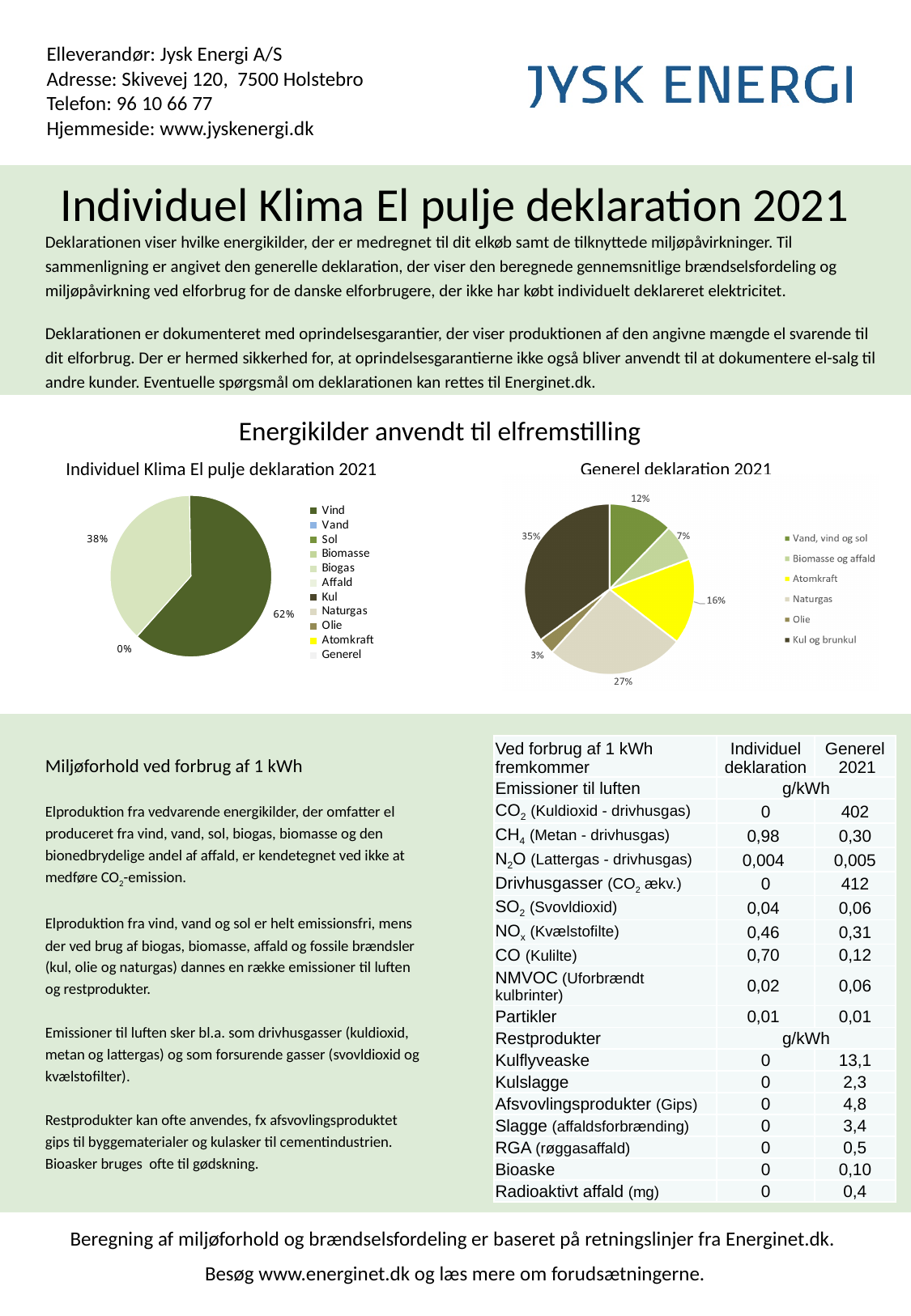
In the 'Generel deklaration 2021' chart, which is larger: Vand, vind og sol or Biomasse og affald? Vand, vind og sol In the 'Generel deklaration 2021' chart, which category has the largest slice? Kul og brunkul How many entries does the legend of the 'Individuel Klima El pulje deklaration 2021' chart list? 11 In the 'Generel deklaration 2021' chart, which category has the smallest slice? Olie In the 'Individuel Klima El pulje deklaration 2021' chart, what is the share of the largest slice? 62% In the 'Generel deklaration 2021' chart, how many percentage points larger is Kul og brunkul than Naturgas? 8% In the 'Generel deklaration 2021' chart, what share does Atomkraft have? 16% In the 'Generel deklaration 2021' chart, what share does Olie have? 3% In the 'Generel deklaration 2021' chart, what share does Naturgas have? 27% How many categories does the legend of the 'Generel deklaration 2021' chart list? 6 What kind of chart is the 'Individuel Klima El pulje deklaration 2021' chart? pie chart In the 'Individuel Klima El pulje deklaration 2021' chart, which category has the largest slice? Vind